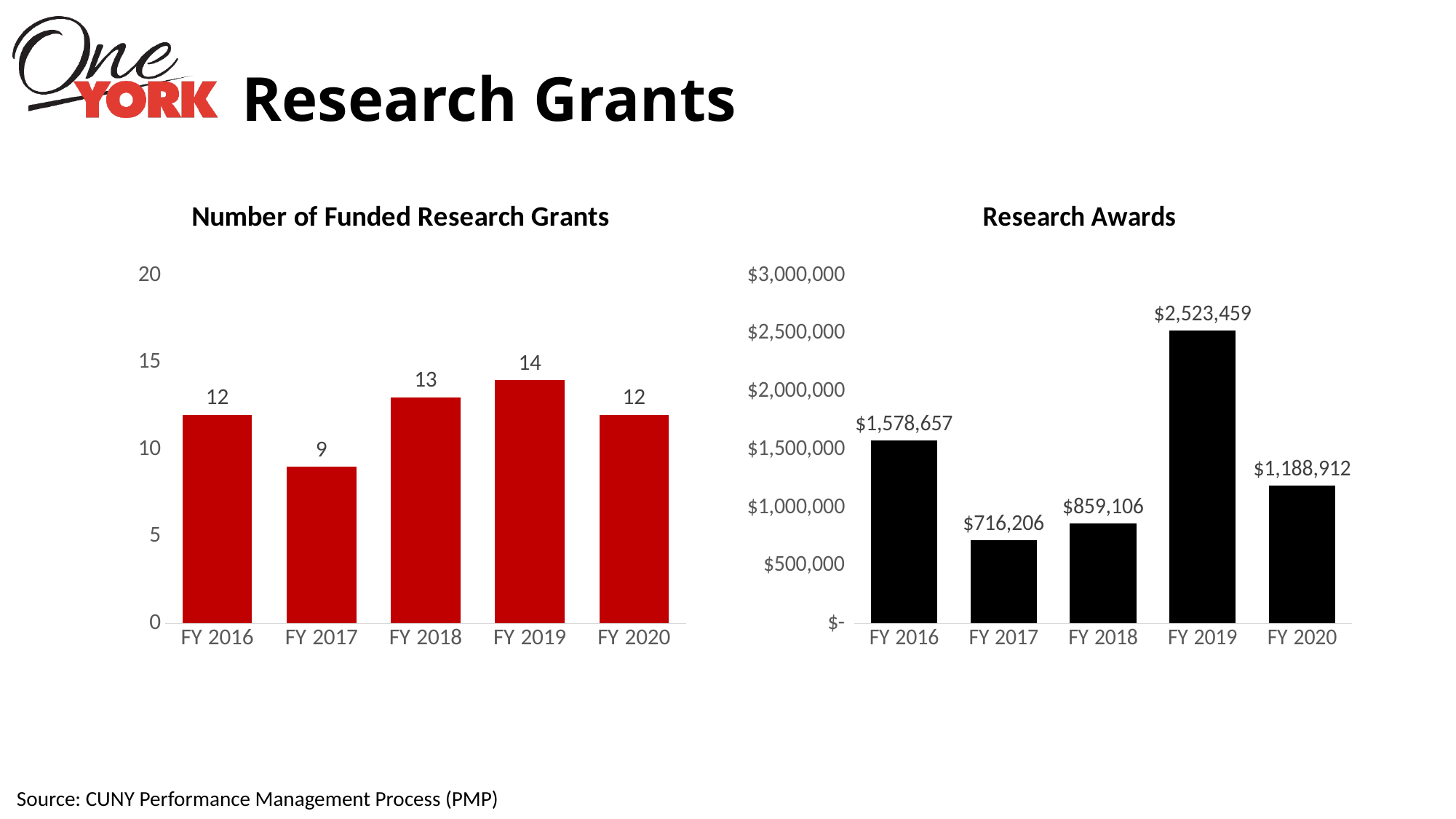
What colour are the bars in the 'Number of Funded Research Grants' chart? Red In the 'Number of Funded Research Grants' chart, what is the value for FY 2017? 9 In the 'Research Awards' chart, what is the value for FY 2018? $859,106 What kind of chart is the 'Research Awards' chart? Bar chart In the 'Research Awards' chart, which is larger, FY 2016 or FY 2020? FY 2016 In the 'Research Awards' chart, what is the value for FY 2019? $2,523,459 In the 'Number of Funded Research Grants' chart, which fiscal year has the highest number of grants? FY 2019 In the 'Number of Funded Research Grants' chart, which fiscal year has the lowest number of grants? FY 2017 In the 'Research Awards' chart, what is the difference between FY 2016 and FY 2020? $389,745 In the 'Number of Funded Research Grants' chart, what is the difference between FY 2019 and FY 2017? 5 In the 'Research Awards' chart, which fiscal year has the lowest research awards? FY 2017 In the 'Number of Funded Research Grants' chart, how many fiscal years are shown? 5